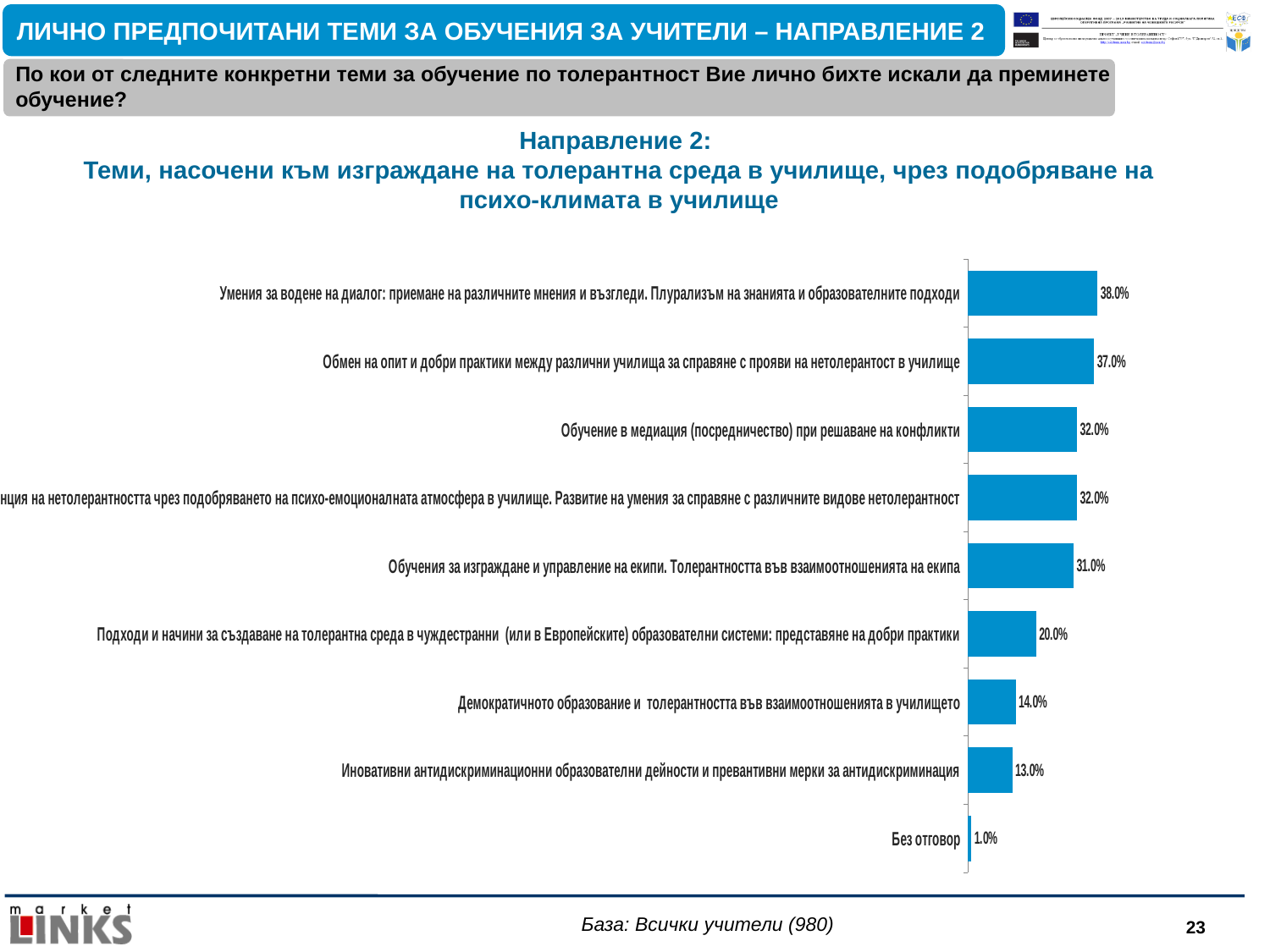
According to the note below the chart, what is the base (number of respondents) for the chart? Всички учители (980) Which category has the lowest value? Без отговор How many categories (bars) does the chart show? 9 What is the value for "Умения за водене на диалог: приемане на различните мнения и възгледи. Плурализъм на знанията и образователните подходи"? 38.0% What is the difference between the values for "Умения за водене на диалог..." and "Обмен на опит и добри практики между различни училища..."? 1.0 percentage point What is the difference between the values for "Подходи и начини за създаване на толерантна среда в чуждестранни (или в Европейските) образователни системи: представяне на добри практики" and "Демократичното образование и толерантността във взаимоотношенията в училището"? 6.0 percentage points What is the value for "Без отговор"? 1.0% Which is larger: the value for "Обучение в медиация (посредничество) при решаване на конфликти" or for "Обучения за изграждане и управление на екипи. Толерантността във взаимоотношенията на екипа"? Обучение в медиация (посредничество) при решаване на конфликти What is the value for "Демократичното образование и толерантността във взаимоотношенията в училището"? 14.0% Which category has the highest value? Умения за водене на диалог: приемане на различните мнения и възгледи. Плурализъм на знанията и образователните подходи What kind of chart is shown on the slide? Bar chart What is the value for "Обучение в медиация (посредничество) при решаване на конфликти"? 32.0%